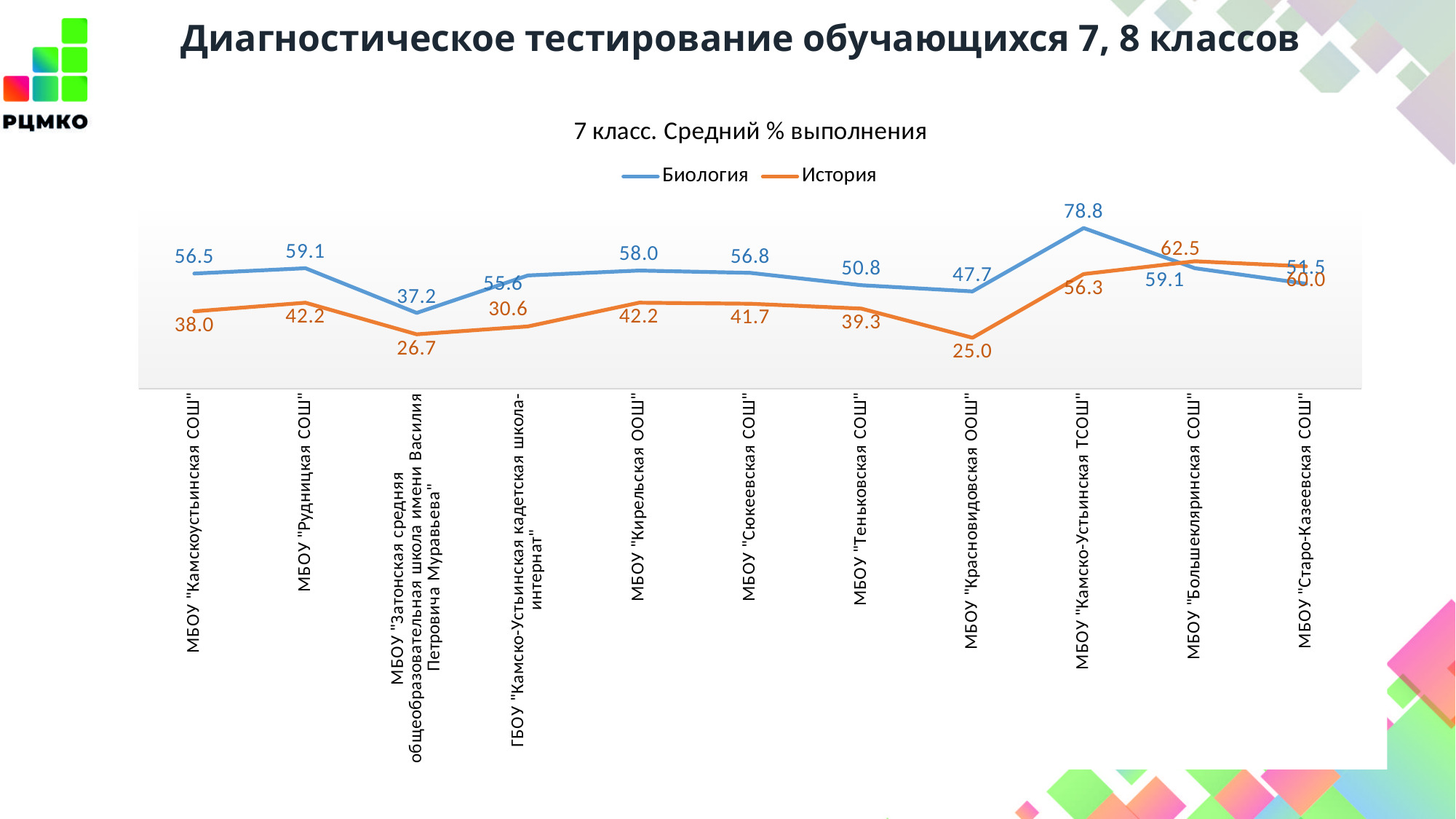
Which is larger for МБОУ "Большекляринская СОШ": the Биология value or the История value? История Which school has the lowest История value? МБОУ "Красновидовская ООШ" What is the difference between the Биология and История values for МБОУ "Камско-Устьинская ТСОШ"? 22.5 How many series does the legend list? 2 What is the Биология value for МБОУ "Камско-Устьинская ТСОШ"? 78.8 What is the История value for ГБОУ "Камско-Устьинская кадетская школа-интернат"? 30.6 Which school has the lowest Биология value? МБОУ "Затонская средняя общеобразовательная школа имени Василия Петровича Муравьева" What is the title of the chart? 7 класс. Средний % выполнения What is the История value for МБОУ "Красновидовская ООШ"? 25.0 How many schools are shown on the x axis? 11 Which school has the highest Биология value? МБОУ "Камско-Устьинская ТСОШ" What kind of chart is shown? Line chart